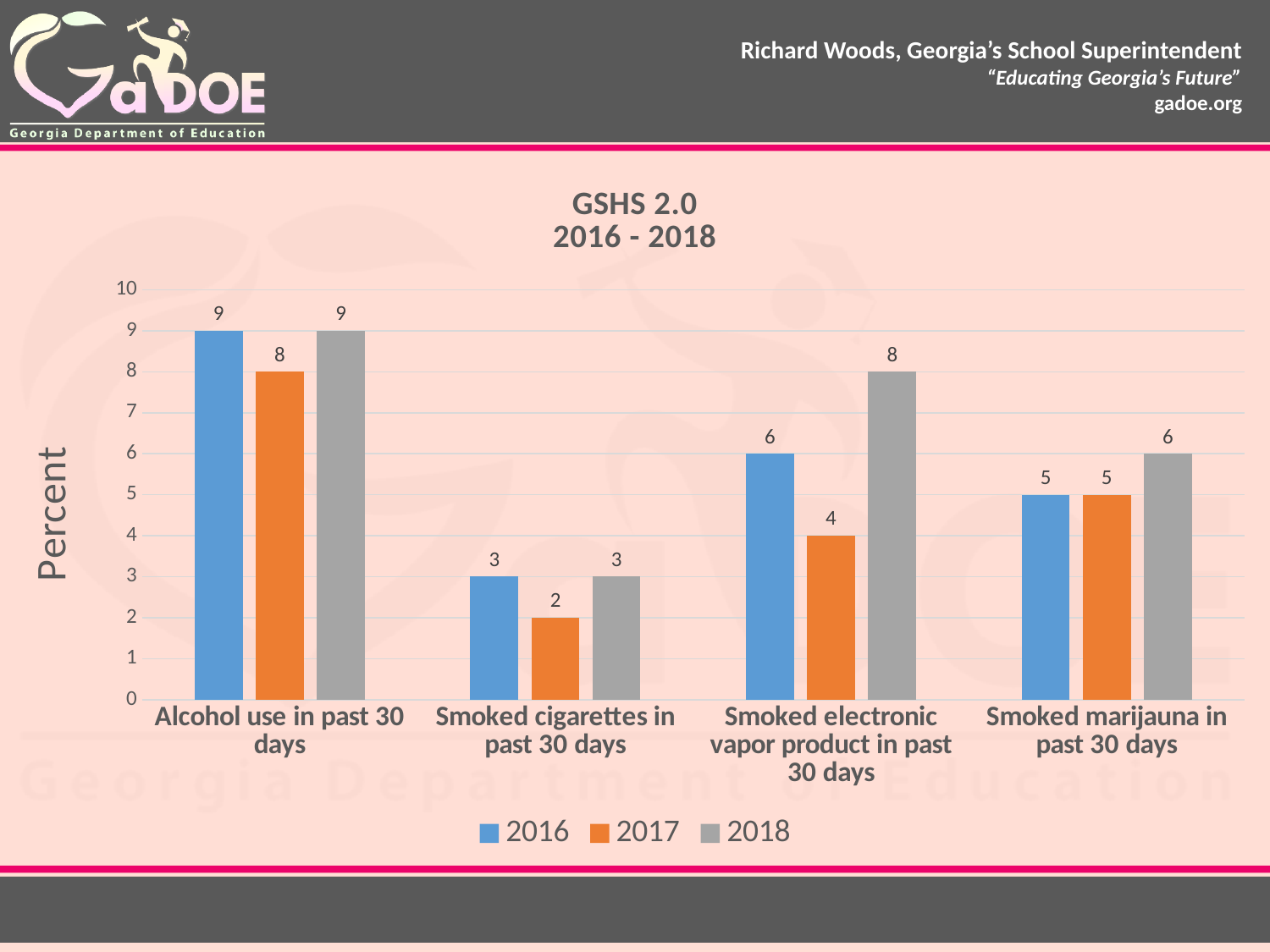
Which category has the highest 2018 value? Alcohol use in past 30 days What is the 2016 value for Alcohol use in past 30 days? 9 What is the 2017 value for Smoked cigarettes in past 30 days? 2 How many series does the legend list? 3 What is the label on the vertical axis? Percent What kind of chart is shown? Bar chart Which is larger for Smoked electronic vapor product in past 30 days: the 2016 value or the 2017 value? 2016 How many categories are shown on the x axis? 4 What is the difference between the 2018 and 2017 values for Smoked electronic vapor product in past 30 days? 4 Which category has the lowest 2017 value? Smoked cigarettes in past 30 days What is the 2017 value for Smoked marijauna in past 30 days? 5 What is the 2018 value for Smoked electronic vapor product in past 30 days? 8